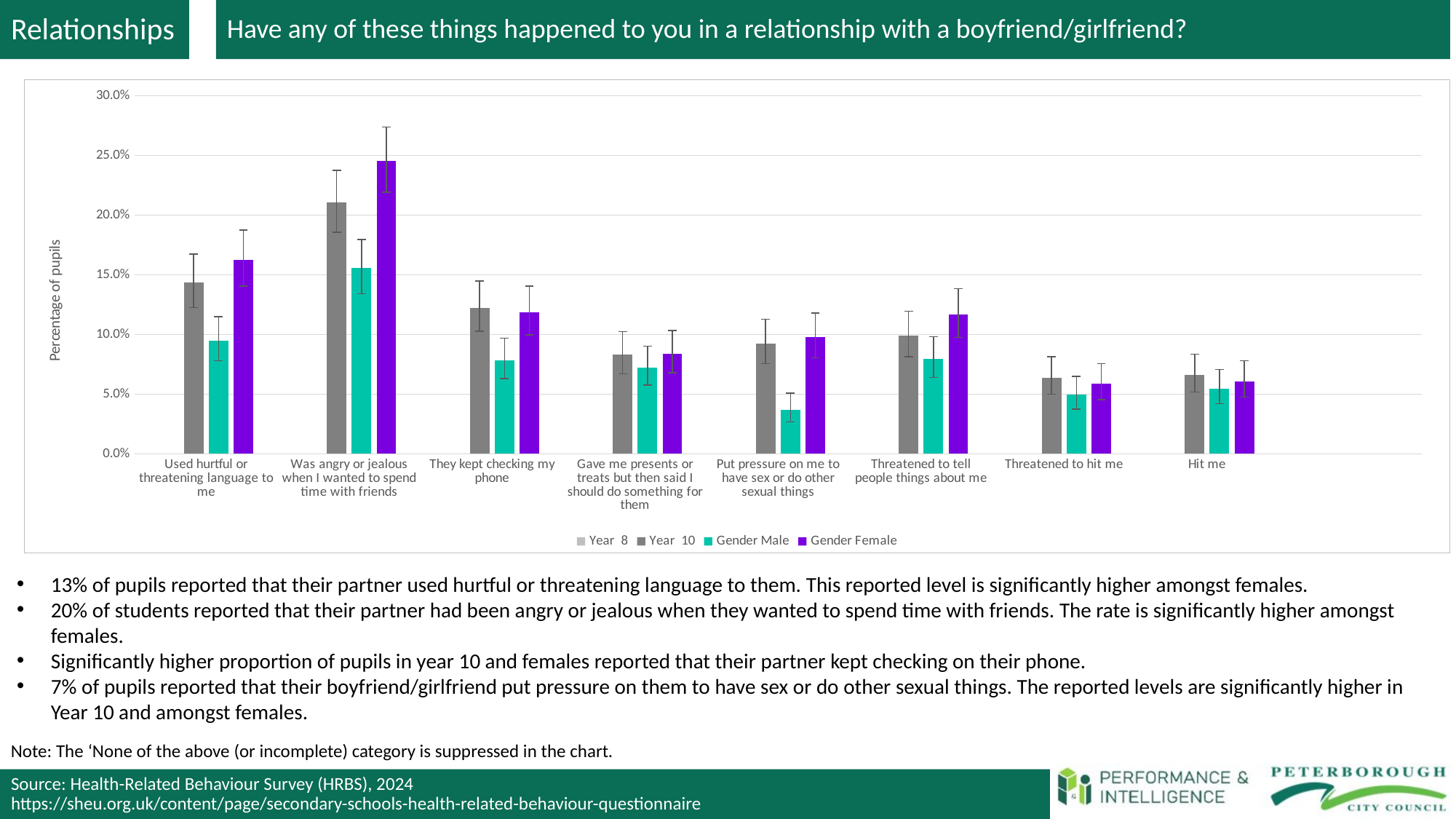
For which category is the Gender Male value highest? Was angry or jealous when I wanted to spend time with friends How many categories are shown along the x axis of the chart? 8 Is the Gender Female value for 'Threatened to tell people things about me' greater or less than 10.0%? greater Is the Gender Male value for 'They kept checking my phone' greater or less than 10.0%? less What is the label of the chart's vertical axis? Percentage of pupils Is the Gender Female value for 'Was angry or jealous when I wanted to spend time with friends' greater or less than 20.0%? greater For which category is the Gender Female value highest? Was angry or jealous when I wanted to spend time with friends What kind of chart is shown on the slide? bar chart How many series does the chart legend list? 4 For which category is the Gender Male value lowest? Put pressure on me to have sex or do other sexual things For 'Used hurtful or threatening language to me', which is larger: the Gender Male value or the Gender Female value? Gender Female